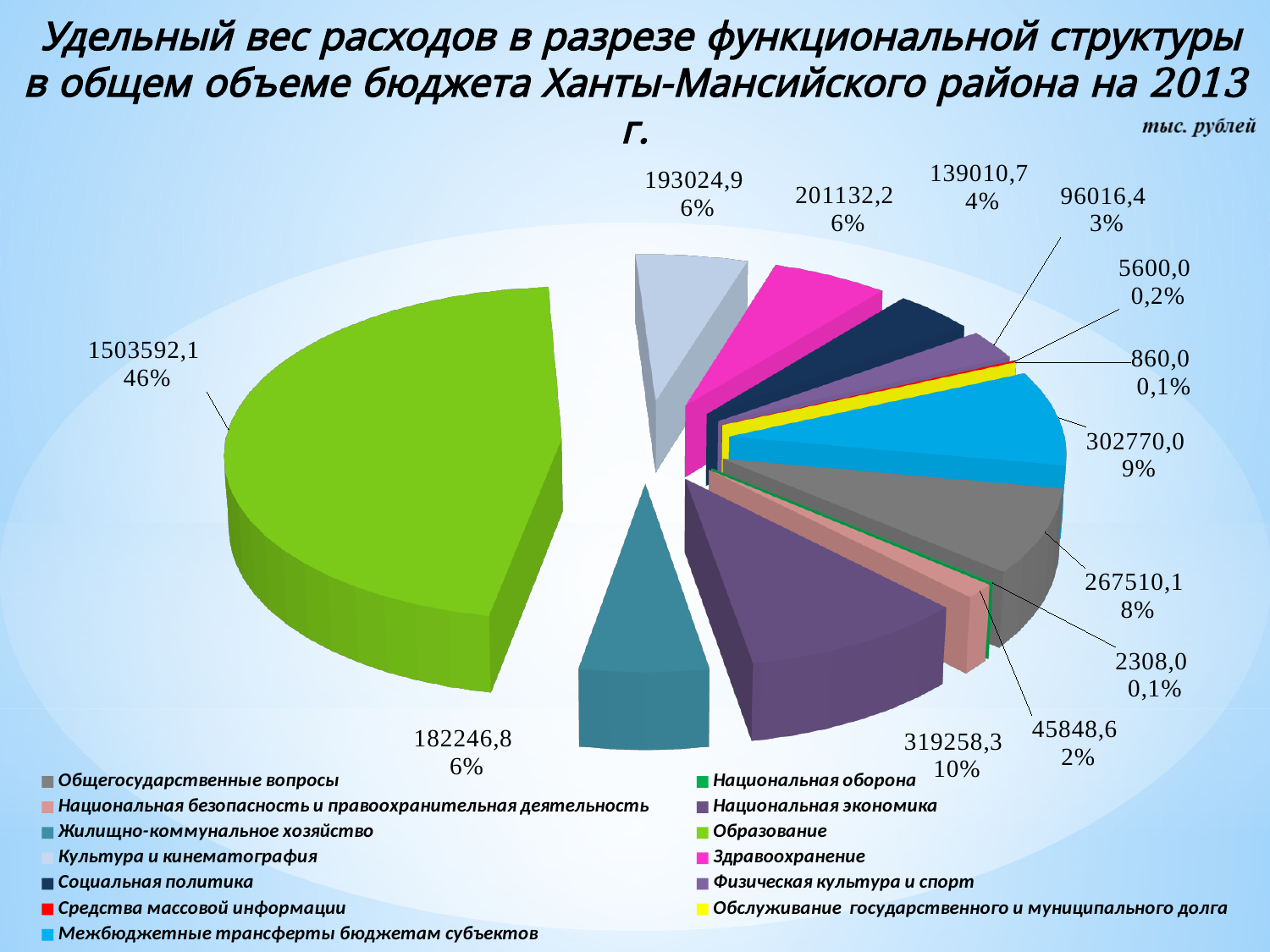
What type of chart is shown on the slide? Pie chart What is the value for Национальная экономика? 319258,3 In what units are the values on the chart given, according to the note in the top right? тыс. рублей What is the smallest value labelled on the pie chart? 860,0 How many categories does the legend of the pie chart list? 13 What is the value for Образование? 1503592,1 What share of the pie does Межбюджетные трансферты бюджетам субъектов account for? 9% What is the value for Жилищно-коммунальное хозяйство? 182246,8 What is the difference between the values for Национальная экономика and Общегосударственные вопросы? 51748,2 Which is larger: Национальная экономика or Общегосударственные вопросы? Национальная экономика What share of the pie does Образование account for? 46% Which category has the largest share of the pie? Образование